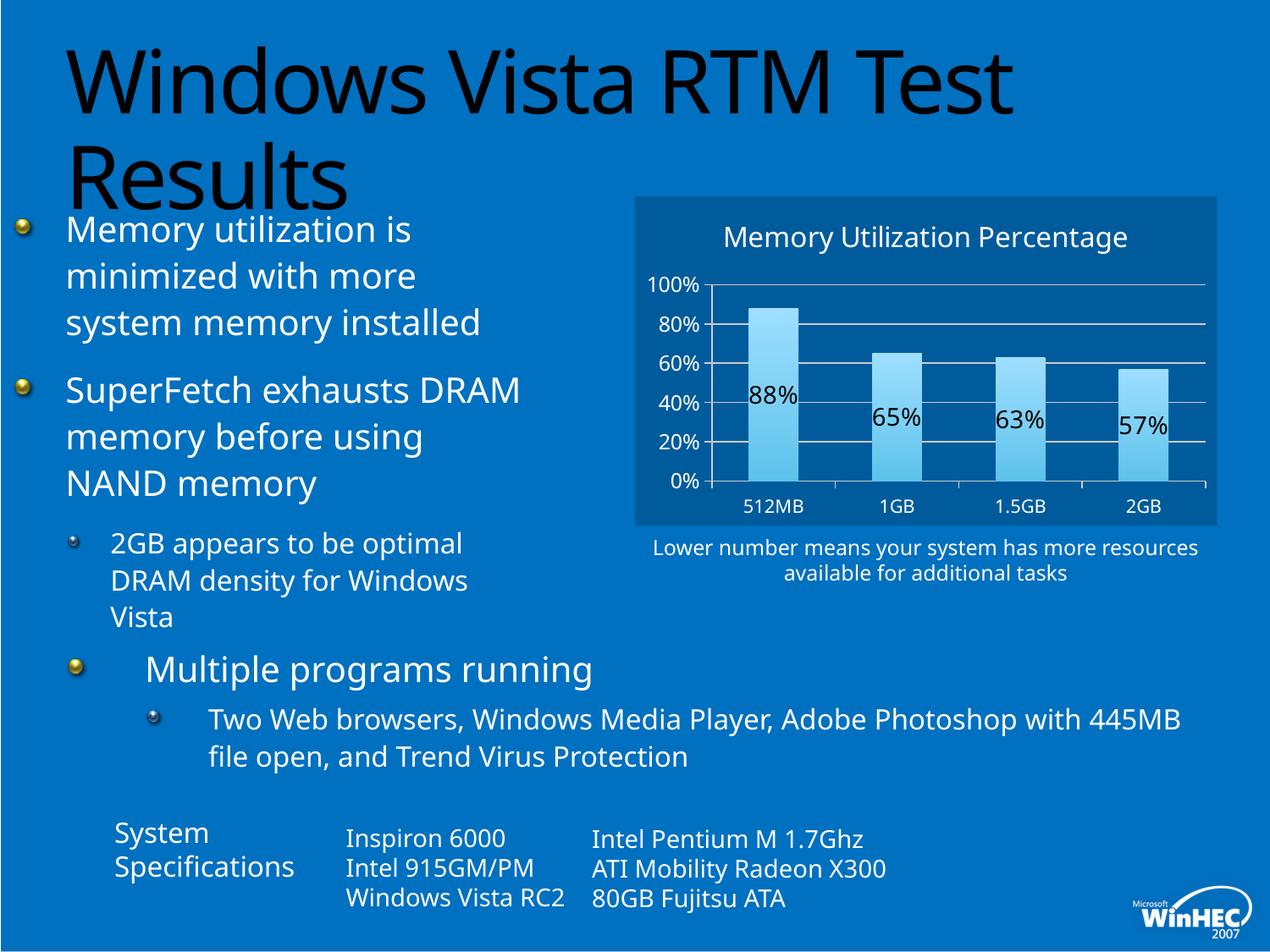
What type of chart is used to show Memory Utilization Percentage? bar chart Which has a higher memory utilization percentage, 1GB or 2GB? 1GB Does memory utilization percentage rise or fall as system memory increases from 512MB to 2GB? fall How many memory configurations are shown in the chart? 4 What is the difference in memory utilization percentage between 512MB and 2GB? 31% What is the memory utilization percentage for 512MB? 88% What is the memory utilization percentage for 1.5GB? 63% What is the difference in memory utilization percentage between 1GB and 1.5GB? 2% Which memory configuration has the lowest memory utilization percentage? 2GB What is the memory utilization percentage for 2GB? 57% Is the memory utilization percentage for 1.5GB greater or less than 80%? less Which memory configuration has the highest memory utilization percentage? 512MB